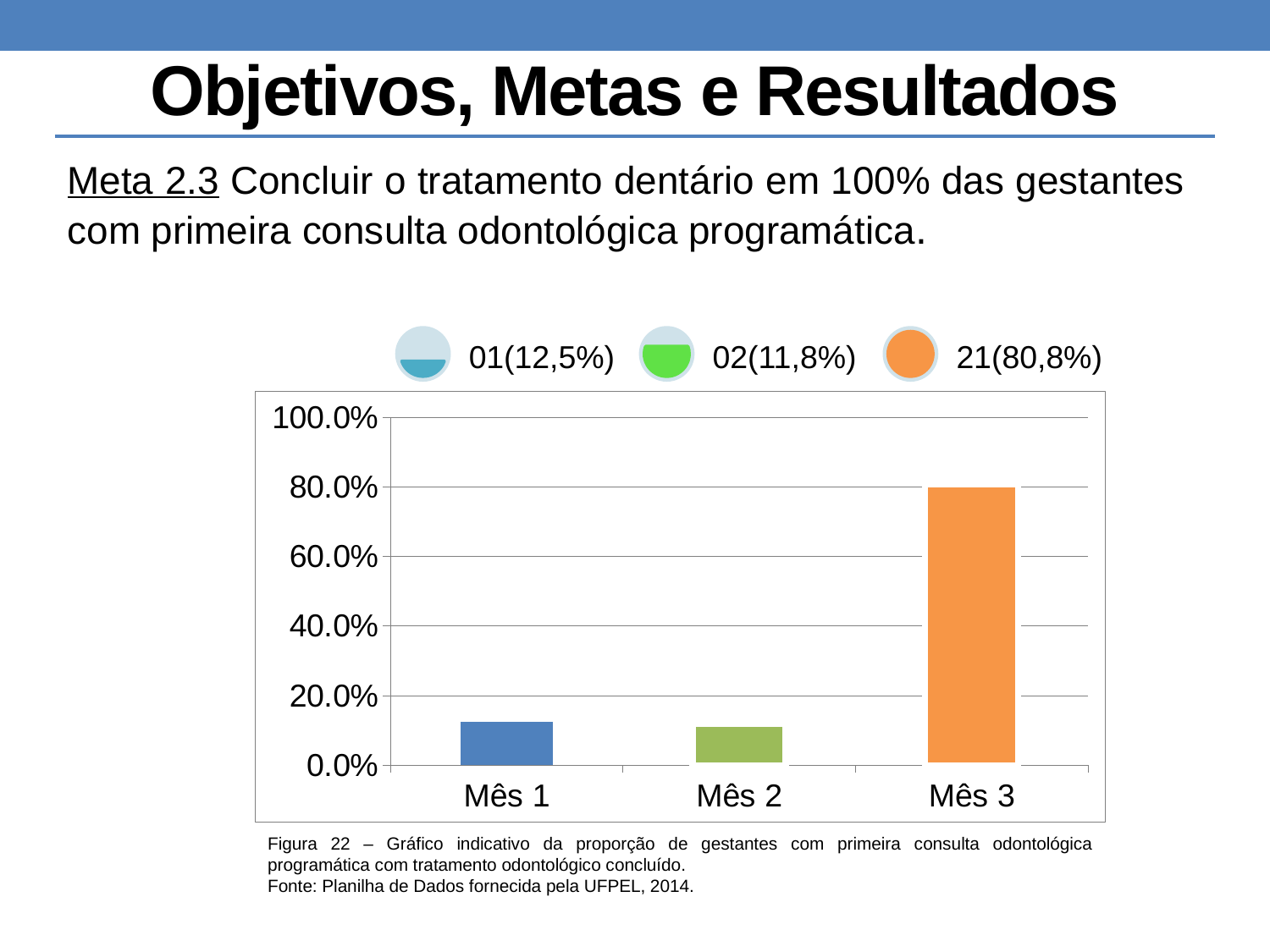
Is the value for Mês 3 greater or less than 60.0%? greater What percentage is shown for Mês 1 in the chart? 12,5% Is the value for Mês 1 greater or less than 20.0%? less Which month has the highest value in the chart? Mês 3 Which is larger, the value for Mês 1 or the value for Mês 3? Mês 3 What percentage is shown for Mês 3 in the chart? 80,8% How many categories (months) are plotted on the x axis of the chart? 3 How many pregnant women are indicated for Mês 3 in the label above the chart? 21 What is the highest value shown on the y axis of the chart? 100.0% What percentage is shown for Mês 2 in the chart? 11,8% What kind of chart is shown on the slide? bar chart Which month has the lowest value in the chart? Mês 2